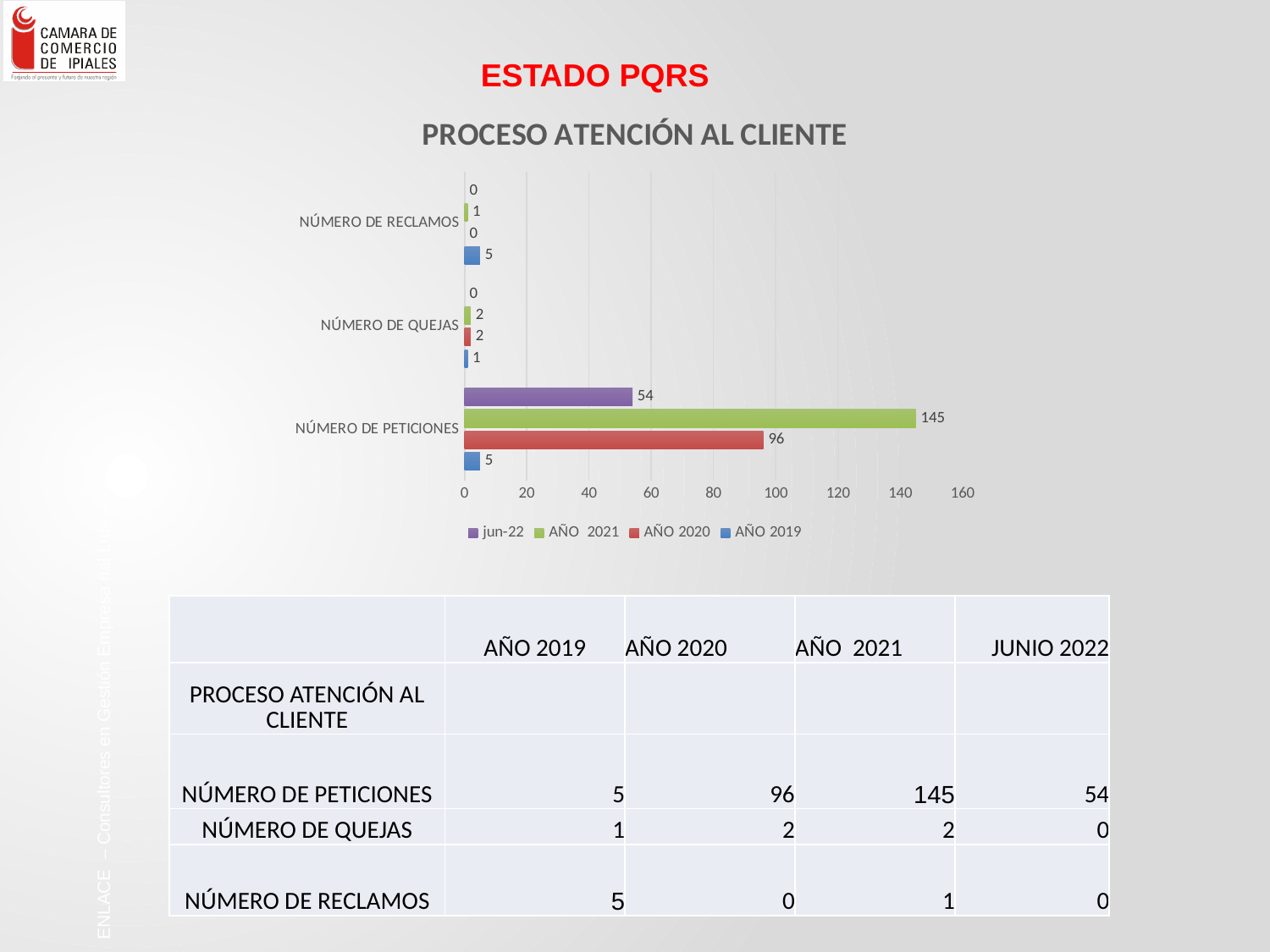
What is the value for NÚMERO DE PETICIONES in the AÑO 2021 series? 145 What is the difference between the AÑO 2021 and AÑO 2020 values for NÚMERO DE PETICIONES? 49 What is the value for NÚMERO DE QUEJAS in the AÑO 2020 series? 2 Which is larger for NÚMERO DE PETICIONES: the AÑO 2020 value or the jun-22 value? AÑO 2020 What is the value for NÚMERO DE PETICIONES in the jun-22 series? 54 What is the value for NÚMERO DE RECLAMOS in the AÑO 2019 series? 5 Which series has the highest value for NÚMERO DE PETICIONES? AÑO 2021 How many categories are shown on the chart? 3 Which series has the lowest value for NÚMERO DE PETICIONES? AÑO 2019 Is the AÑO 2021 value for NÚMERO DE PETICIONES greater or less than 140? greater How many series does the legend list? 4 What kind of chart is shown on the slide? Bar chart